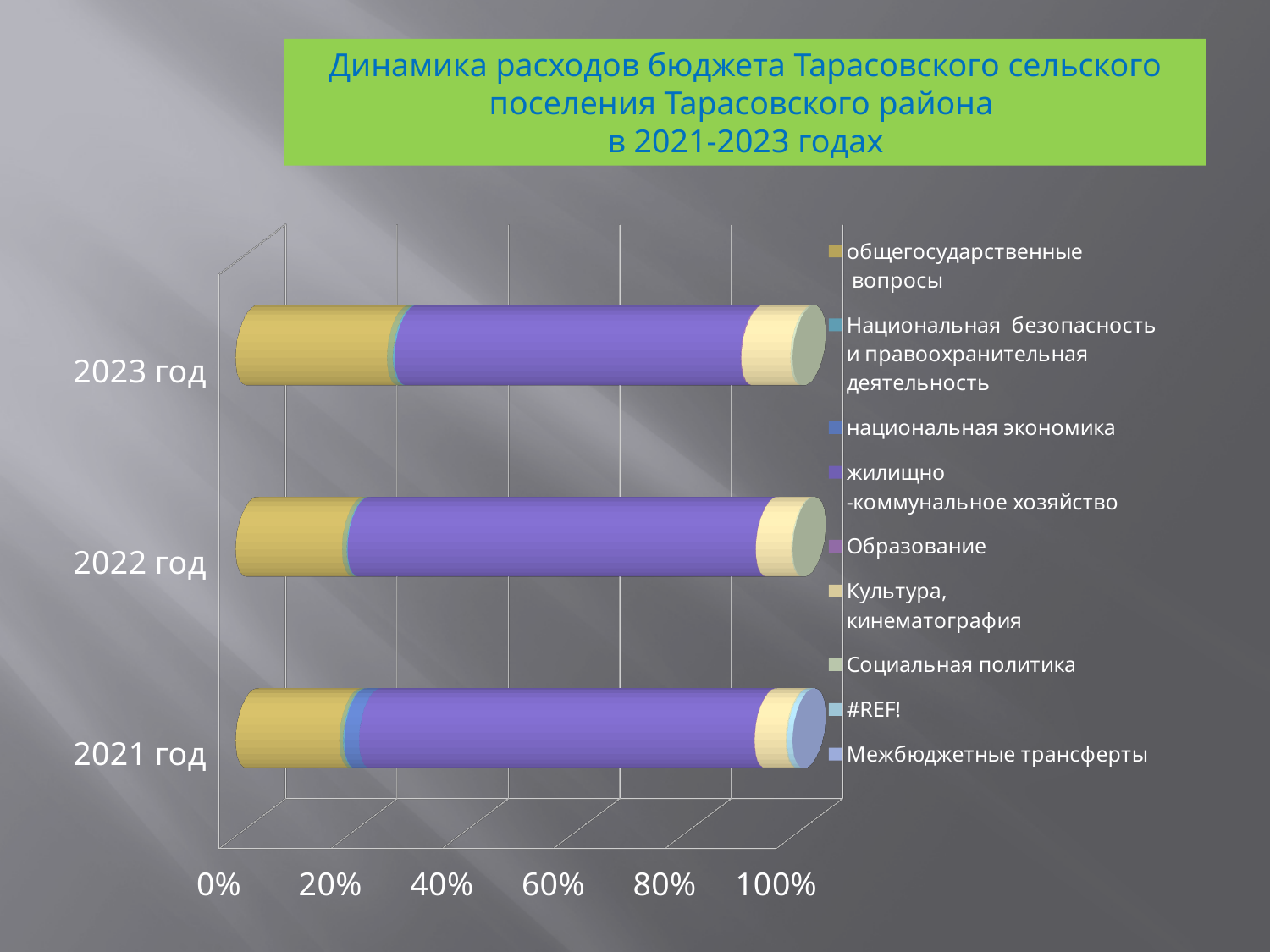
How many years (categories) are plotted on the chart? 3 What kind of chart is shown on the slide? Stacked bar chart Is the share of жилищно-коммунальное хозяйство in 2021 год greater or less than 60%? greater What is the highest value shown on the horizontal axis? 100% Which legend entry appears as an error reference rather than a category name? #REF! Which series forms the largest segment of the 2022 год bar? жилищно-коммунальное хозяйство Is the share of общегосударственные вопросы in 2023 год greater or less than 40%? less Is the share of жилищно-коммунальное хозяйство in 2023 год greater or less than 40%? greater In the 2023 год bar, which segment is larger: общегосударственные вопросы or жилищно-коммунальное хозяйство? жилищно-коммунальное хозяйство In which year is the общегосударственные вопросы segment the largest? 2023 год How many series does the legend list? 9